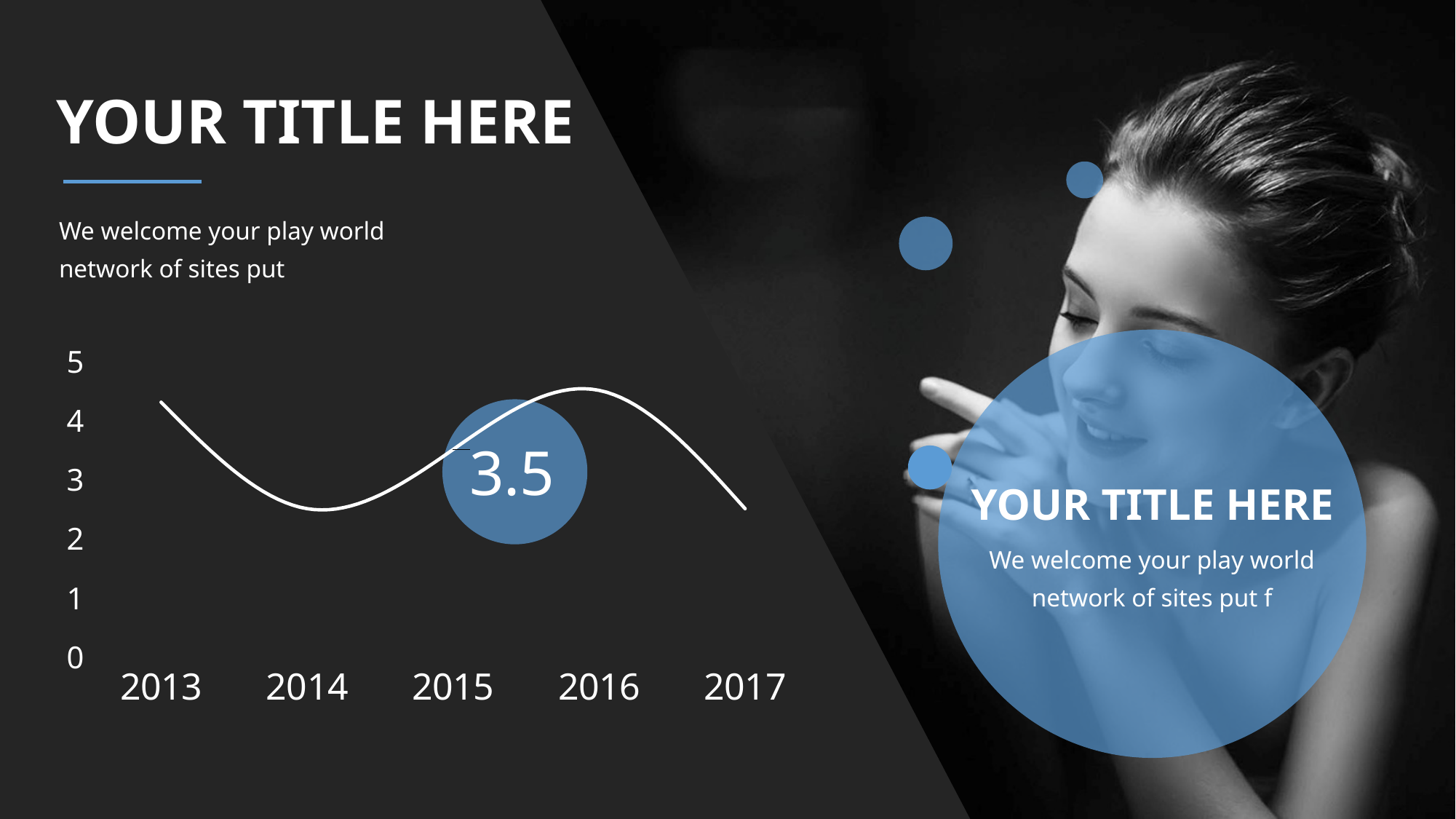
Is the value for 2017 greater or less than 3? less What is the highest value shown on the y axis of the chart? 5 Which has the larger value, 2013 or 2014? 2013 Is the value for 2016 greater or less than 4? greater How many years are shown on the x axis of the chart? 5 Does the line rise or fall from 2016 to 2017? fall Which has the larger value, 2014 or 2016? 2016 Is the value for 2014 greater or less than 3? less Does the line rise or fall from 2013 to 2014? fall What kind of chart is shown on the slide? line chart Which has the larger value, 2015 or 2016? 2016